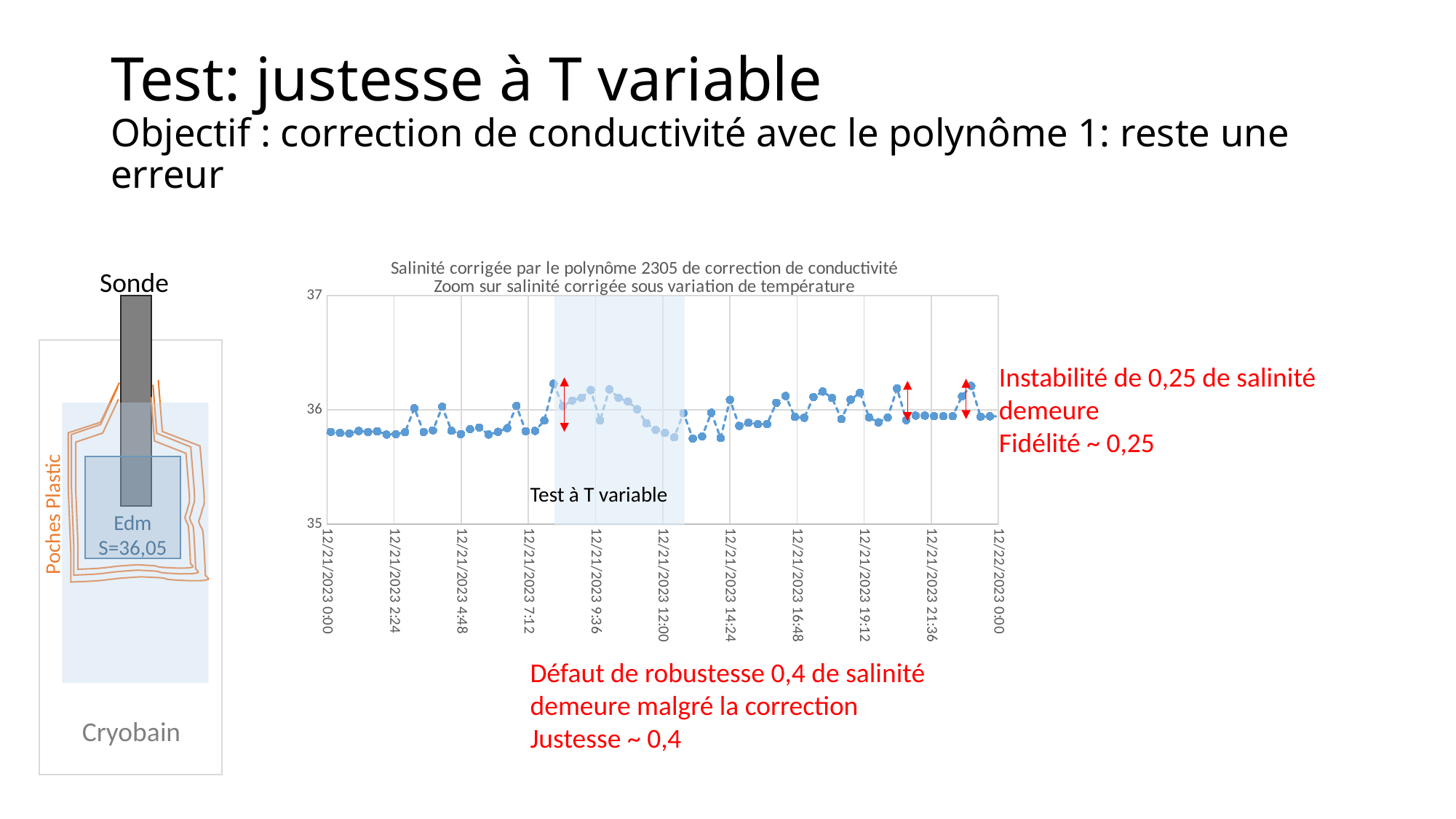
What is the title of the chart? Salinité corrigée par le polynôme 2305 de correction de conductivité Zoom sur salinité corrigée sous variation de température What label is written inside the shaded region of the chart? Test à T variable Is the value at 12/21/2023 0:00 greater or less than 35? greater What kind of chart is shown on the slide? line chart Is the value at 12/21/2023 0:00 greater or less than 36? less Is the highest plotted value greater or less than 37? less How many date-time tick labels are shown on the x axis? 11